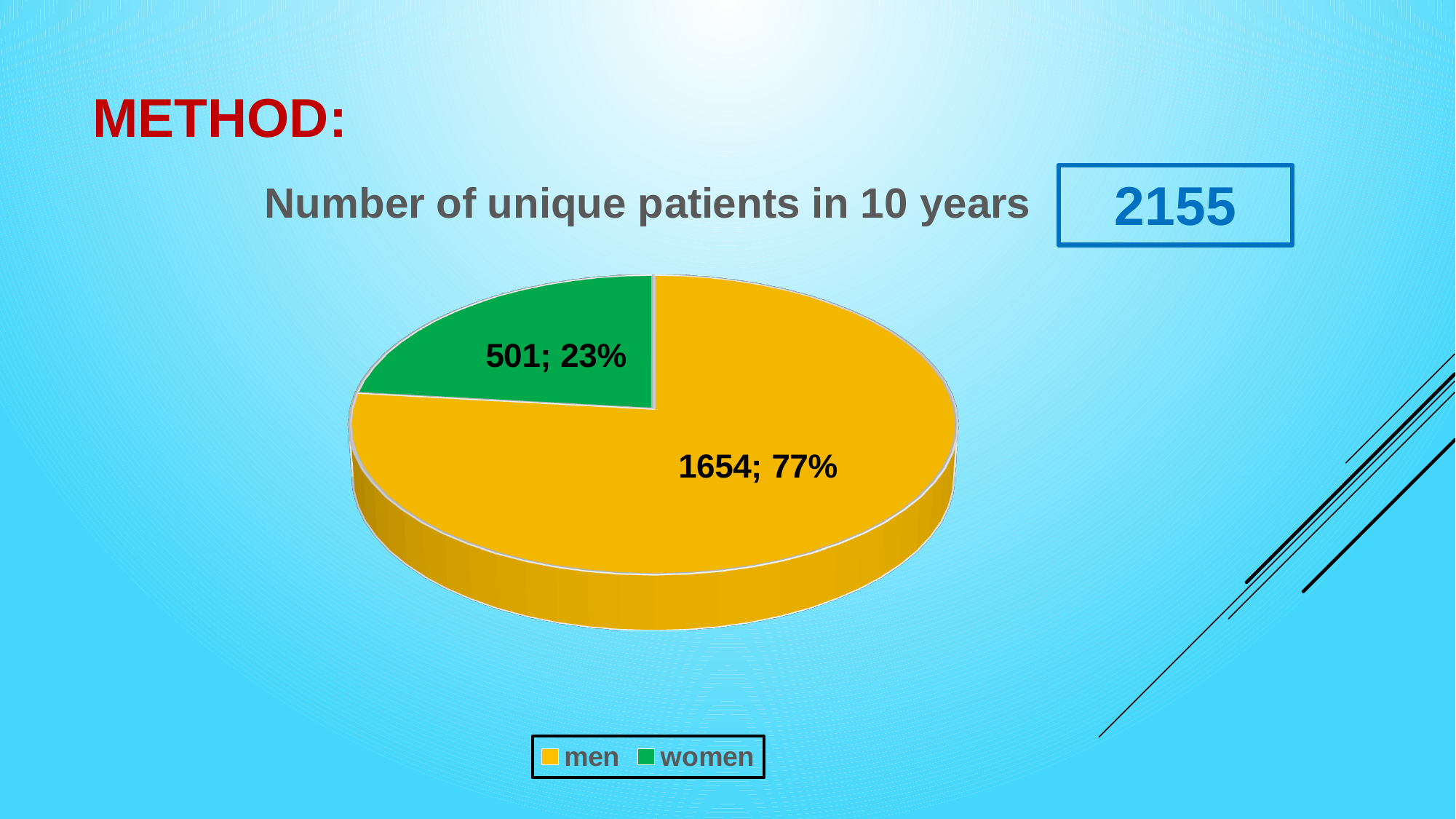
What share of the pie do women represent? 23% How many unique patients were women? 501 What share of the pie do men represent? 77% What kind of chart is shown on the slide? pie chart What is the difference between the number of men and the number of women? 1153 What is the title of the chart? Number of unique patients in 10 years Which category has the smallest slice of the pie? women How many categories does the pie chart have? 2 What colour is the slice for women? green Which is larger, the number of men or the number of women? men Which category has the largest slice of the pie? men How many unique patients were men? 1654